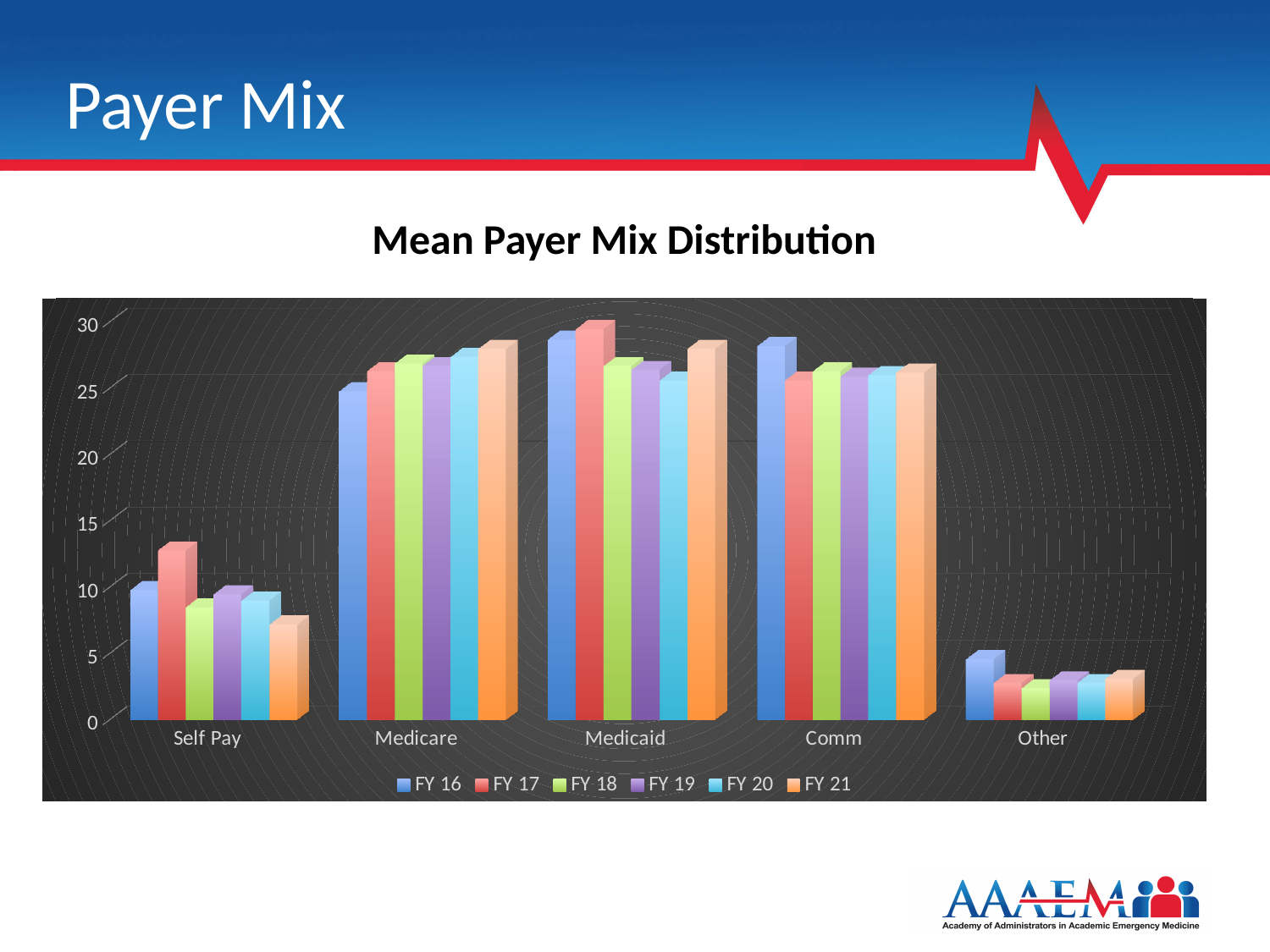
Which payer category has the lowest values across all fiscal years? Other Is the value for Self Pay in FY 17 greater or less than 10? greater Is the value for Other in FY 18 greater or less than 5? less For Medicare, which is larger: the FY 16 value or the FY 21 value? FY 21 Which fiscal years are listed in the legend? FY 16, FY 17, FY 18, FY 19, FY 20, FY 21 How many payer categories are shown on the x axis? 5 Is the value for Medicaid in FY 17 greater or less than 25? greater Within the Other category, which fiscal year has the highest bar? FY 16 What kind of chart is shown on the slide? Bar chart What is the title of the chart? Mean Payer Mix Distribution Within the Self Pay category, which fiscal year has the highest bar? FY 17 How many series does the legend list? 6